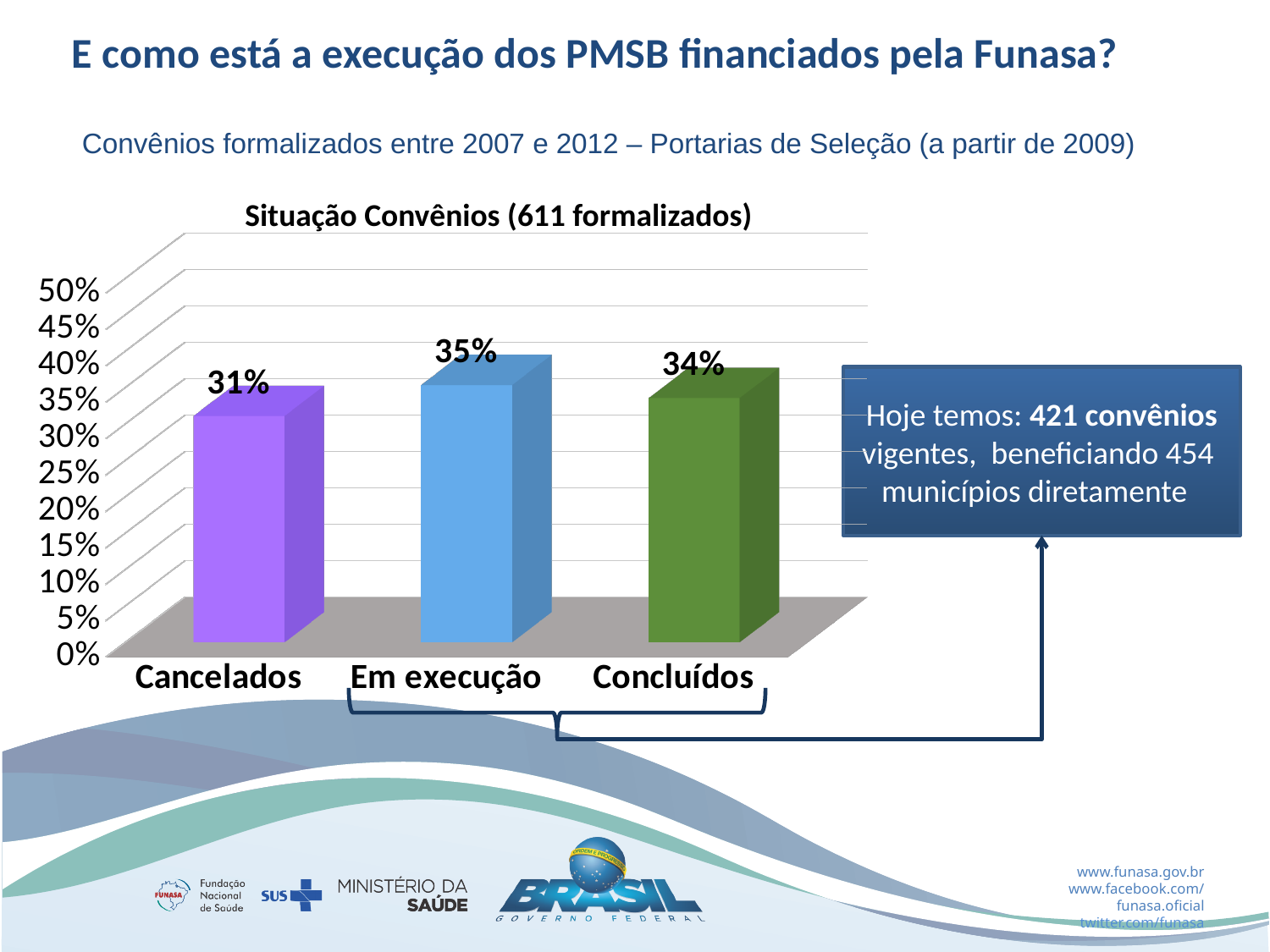
What is the difference between the values for Em execução and Cancelados? 4% Which category has the highest value? Em execução What kind of chart is shown on the slide? bar chart Which is larger, the value for Concluídos or the value for Cancelados? Concluídos Is the value for Cancelados greater or less than 40%? less What is the value for Concluídos? 34% What is the value for Cancelados? 31% What is the value for Em execução? 35% How many categories are shown in the chart? 3 What is the difference between the values for Concluídos and Cancelados? 3% Which category has the lowest value? Cancelados What is the title of the chart? Situação Convênios (611 formalizados)